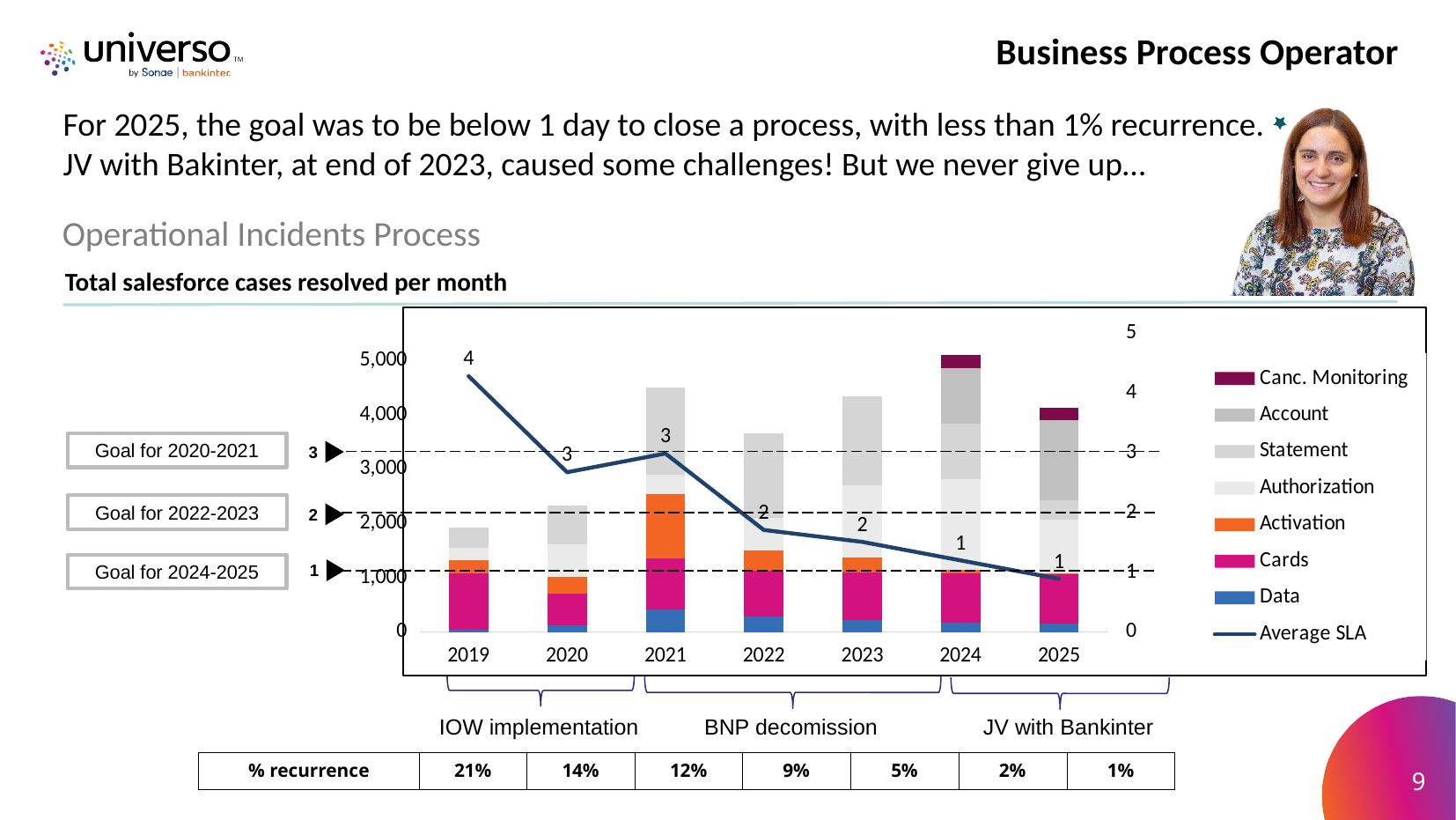
Is the total stacked bar for 2022 greater or less than 4,000? less Which year has the shortest stacked bar of salesforce cases resolved? 2019 Which year has a taller stacked bar, 2021 or 2022? 2021 What is the Average SLA value shown for 2022? 2 What is the Average SLA value shown for 2025? 1 Does the Average SLA line rise or fall from 2019 to 2025? fall How many entries does the chart legend list? 8 What is the difference between the Average SLA in 2019 and in 2025? 3 How many years are shown on the x axis of the chart? 7 What is the Average SLA value shown for 2019? 4 Which year has the tallest stacked bar of salesforce cases resolved? 2024